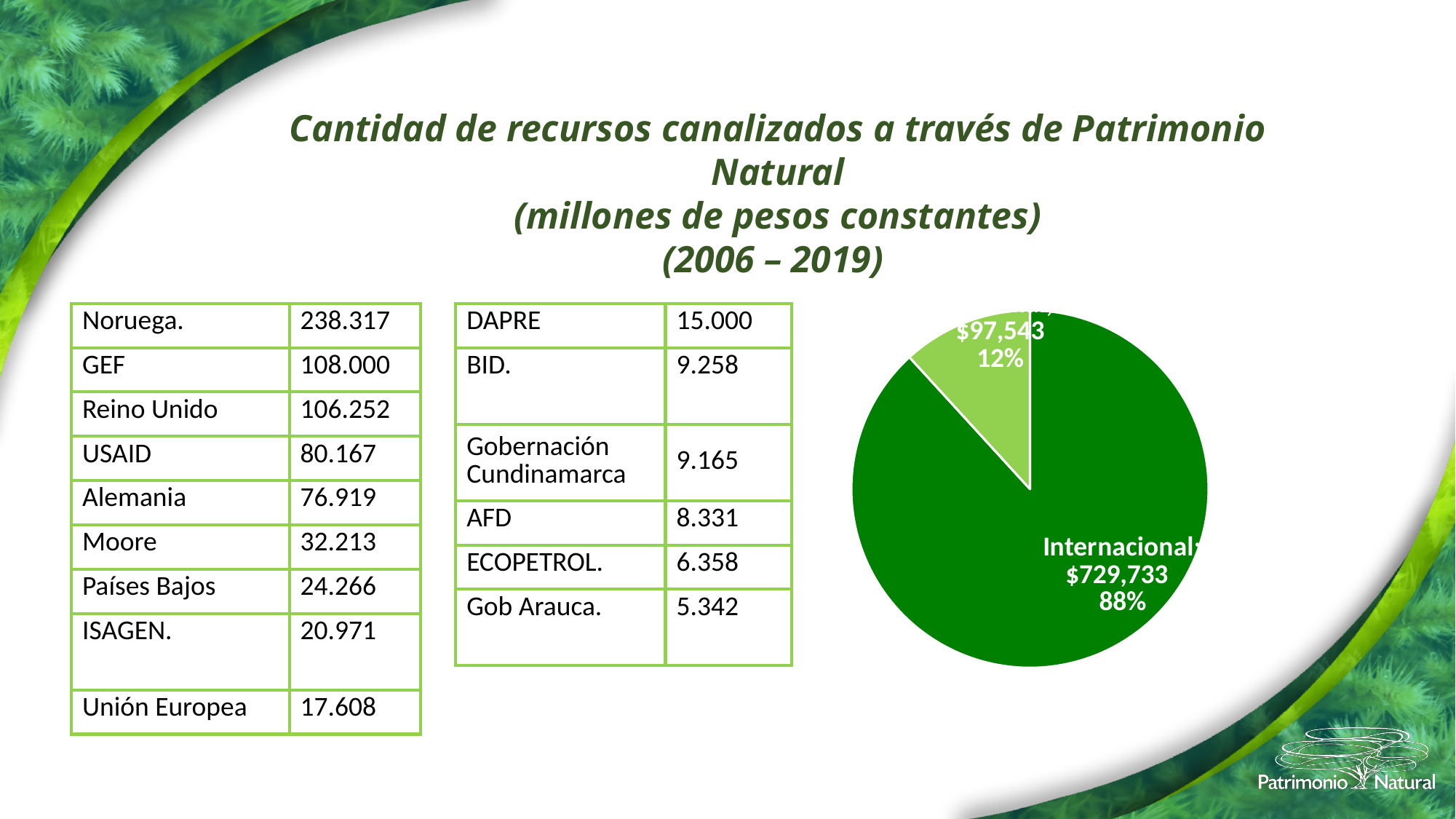
In the pie chart, what share of the pie does the smaller light green slice represent? 12% How many slices does the pie chart have? 2 In the pie chart, what value is shown on the smaller light green slice? $97,543 In the pie chart, what share of the pie does Internacional represent? 88% In the pie chart, what value is shown for Internacional? $729,733 In the pie chart, what is the total of the two slice values? $827,276 In the pie chart, what is the difference between the Internacional value and the value of the smaller light green slice? $632,190 In the pie chart, which is larger: the Internacional slice or the light green slice? Internacional What kind of chart is shown on the right of the slide? pie chart What colour is the Internacional slice in the pie chart? dark green Which slice of the pie chart is the largest? Internacional